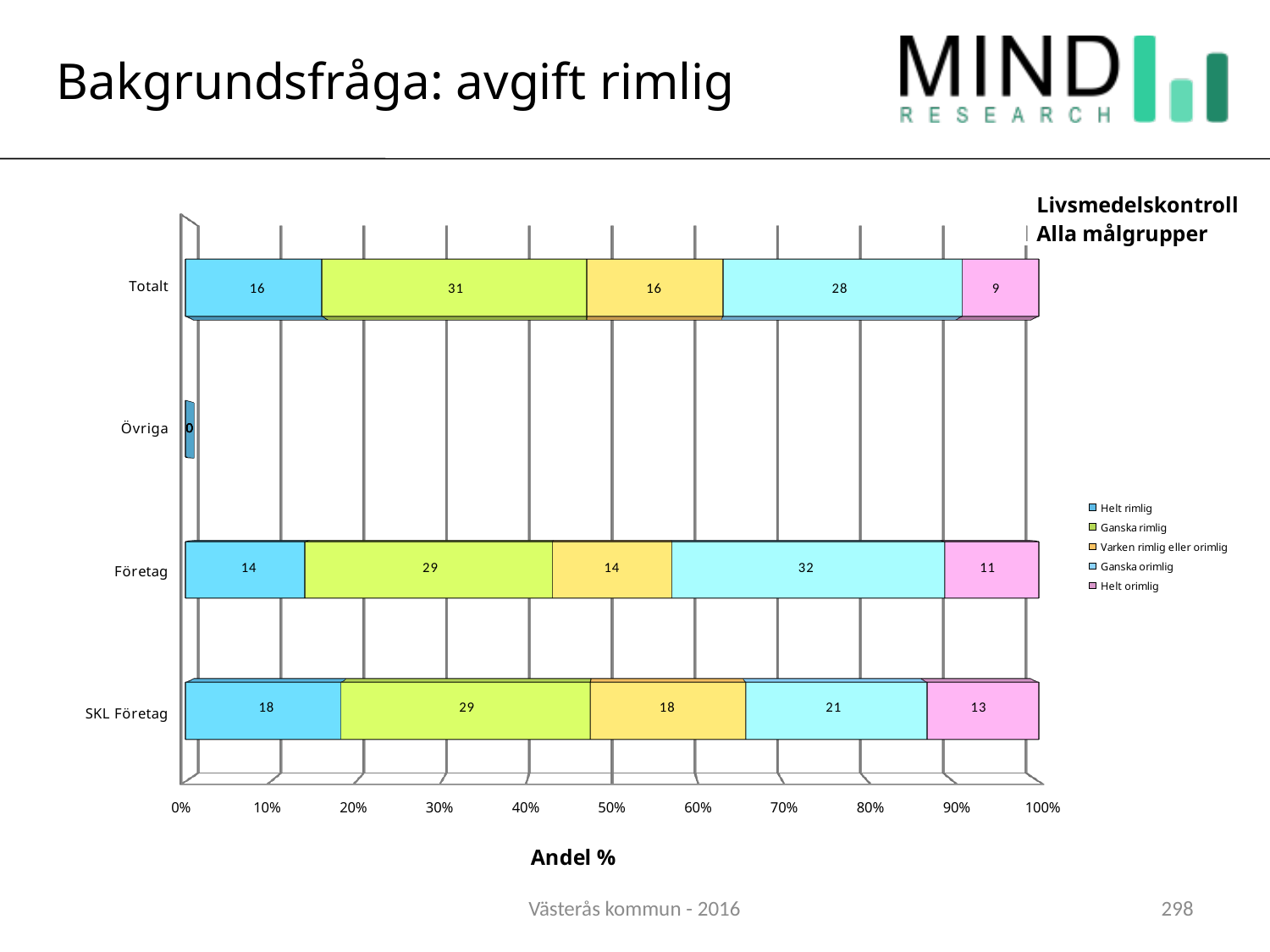
Which is larger: Helt orimlig for Totalt or Helt orimlig for Företag? Företag What is the value for Helt orimlig in the SKL Företag bar? 13 What is the label on the x axis? Andel % What is the value for Ganska rimlig in the Totalt bar? 31 What is the value for Helt rimlig in the SKL Företag bar? 18 What kind of chart is shown on the slide? Stacked bar chart What is the value for Ganska orimlig in the Företag bar? 32 How many series does the legend list? 5 Which category has the highest value for Helt rimlig? SKL Företag What is the total of the Totalt stacked bar? 100 What is the difference between the Ganska orimlig values for Företag and SKL Företag? 11 Which category has the lowest value for Ganska orimlig among Totalt, Företag and SKL Företag? SKL Företag